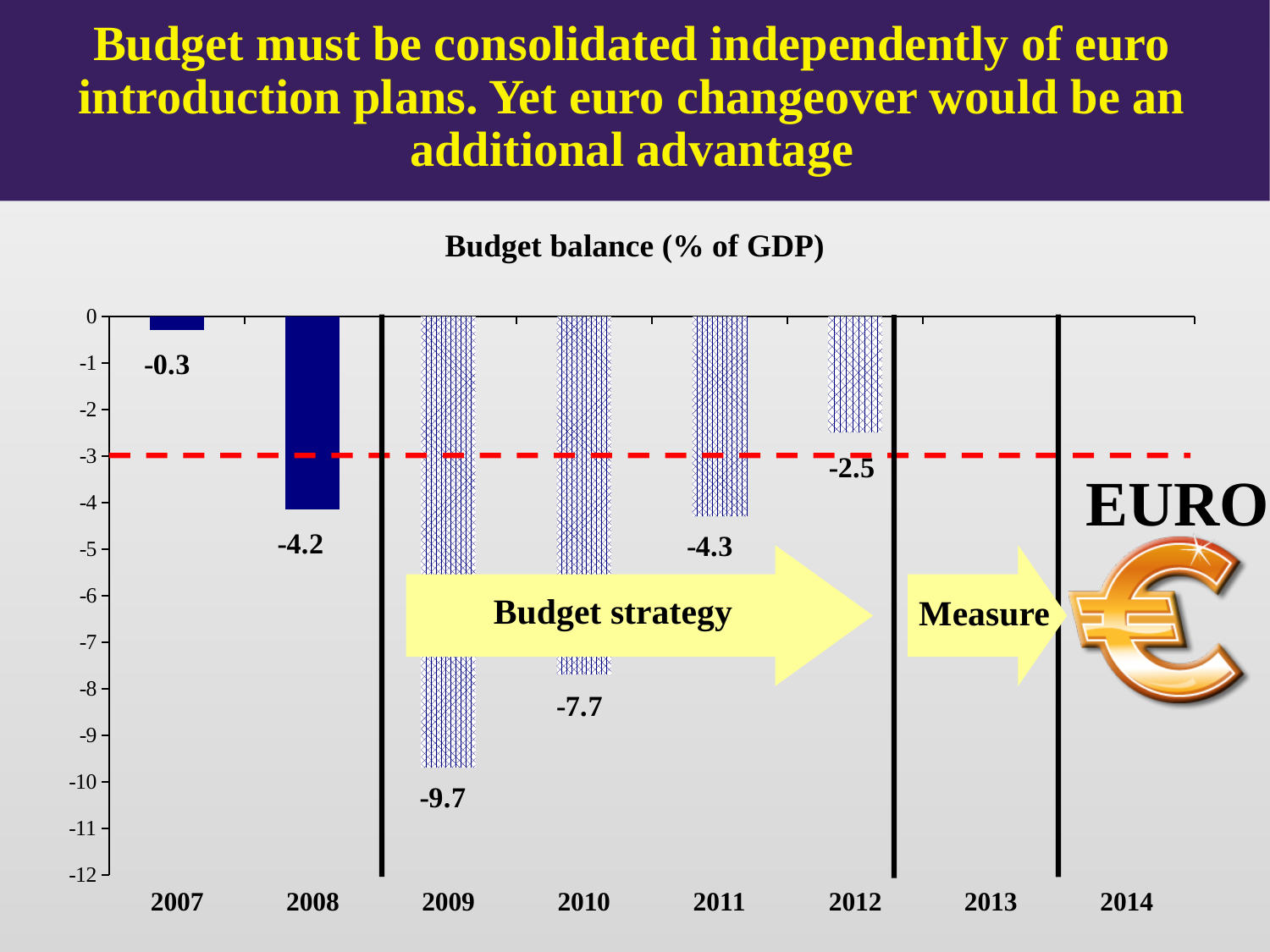
Does the budget balance rise or fall from 2009 to 2012? Rise What is the difference between the budget balance values for 2009 and 2010? 2.0 What is the budget balance value shown for 2011? -4.3 Which year has a more negative budget balance, 2008 or 2011? 2011 What is the budget balance value shown for 2007? -0.3 At what value is the red dashed horizontal line drawn? -3 Which year has the lowest (most negative) budget balance? 2009 What is the budget balance value shown for 2012? -2.5 How many years have a bar plotted in the chart? 6 Which year has the highest (least negative) budget balance? 2007 What is the budget balance value shown for 2009? -9.7 What kind of chart is shown on the slide? Bar chart